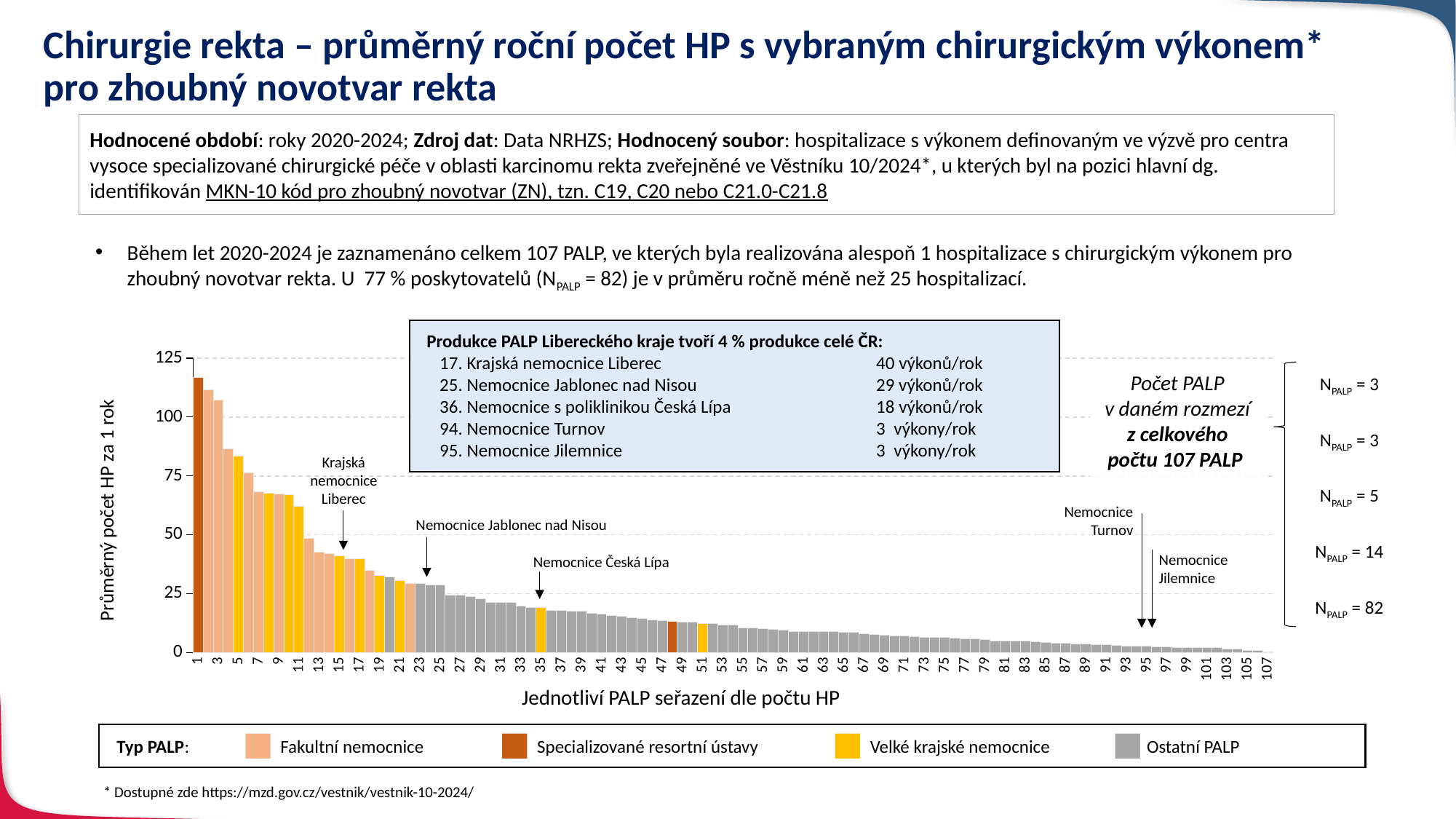
Which has more procedures per year, Nemocnice Jablonec nad Nisou or Nemocnice s poliklinikou Česká Lípa? Nemocnice Jablonec nad Nisou According to the box on the chart, what is the average annual number of procedures for Nemocnice Turnov? 3 výkony/rok Is the value for the PALP at position 40 greater or less than 25? less What is the difference between the annual procedure counts of Krajská nemocnice Liberec and Nemocnice Jablonec nad Nisou? 11 Is the value for the first PALP (position 1) greater or less than 100? greater According to the box on the chart, what is the average annual number of procedures for Krajská nemocnice Liberec? 40 výkonů/rok How many PALP types does the legend (Typ PALP) list? 4 According to the box on the chart, what is the average annual number of procedures for Nemocnice s poliklinikou Česká Lípa? 18 výkonů/rok What kind of chart is shown on the slide? bar chart According to the box on the chart, what is the average annual number of procedures for Nemocnice Jablonec nad Nisou? 29 výkonů/rok How many PALP (providers) are plotted along the x axis of the chart? 107 Do the bar values rise or fall when moving from left to right along the x axis? fall